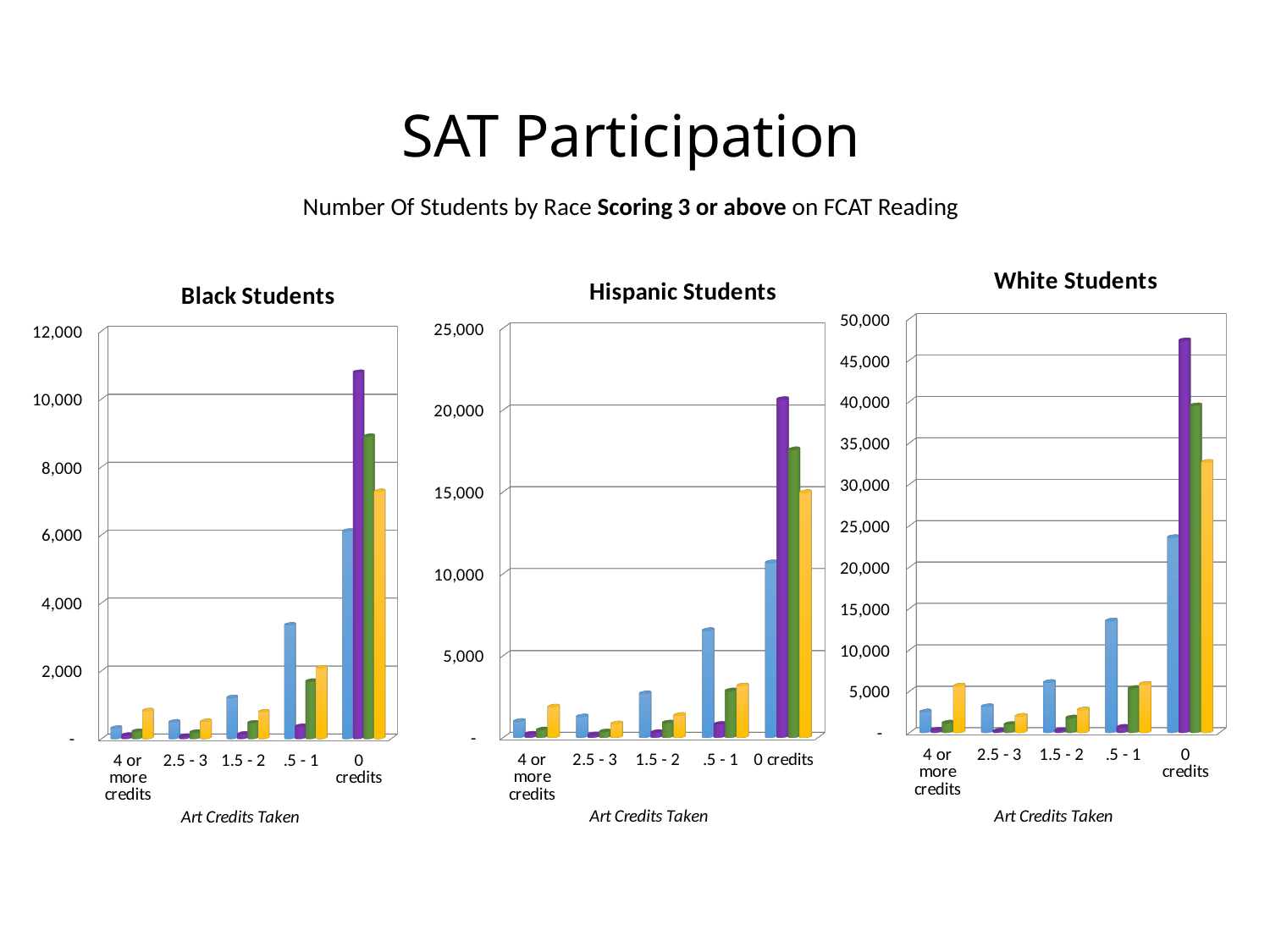
In the White Students chart, which art-credit category has the tallest bars? 0 credits In the White Students chart, is the tallest bar in the 0 credits category greater or less than 45,000? greater How many charts are on the slide? 3 What is the highest value shown on the y axis of the White Students chart? 50,000 In the White Students chart, is the tallest bar in the 2.5 - 3 category greater or less than 5,000? less In the Hispanic Students chart, is the tallest bar in the 0 credits category greater or less than 20,000? greater In the Black Students chart, which art-credit category has the tallest bars? 0 credits What kind of chart is the Black Students chart? bar chart What is the x-axis title shown under each of the three charts? Art Credits Taken Across the categories from left (4 or more credits) to right (0 credits), do the bar heights in the Hispanic Students chart generally rise or fall? rise How many art-credit categories are shown on the x axis of the Hispanic Students chart? 5